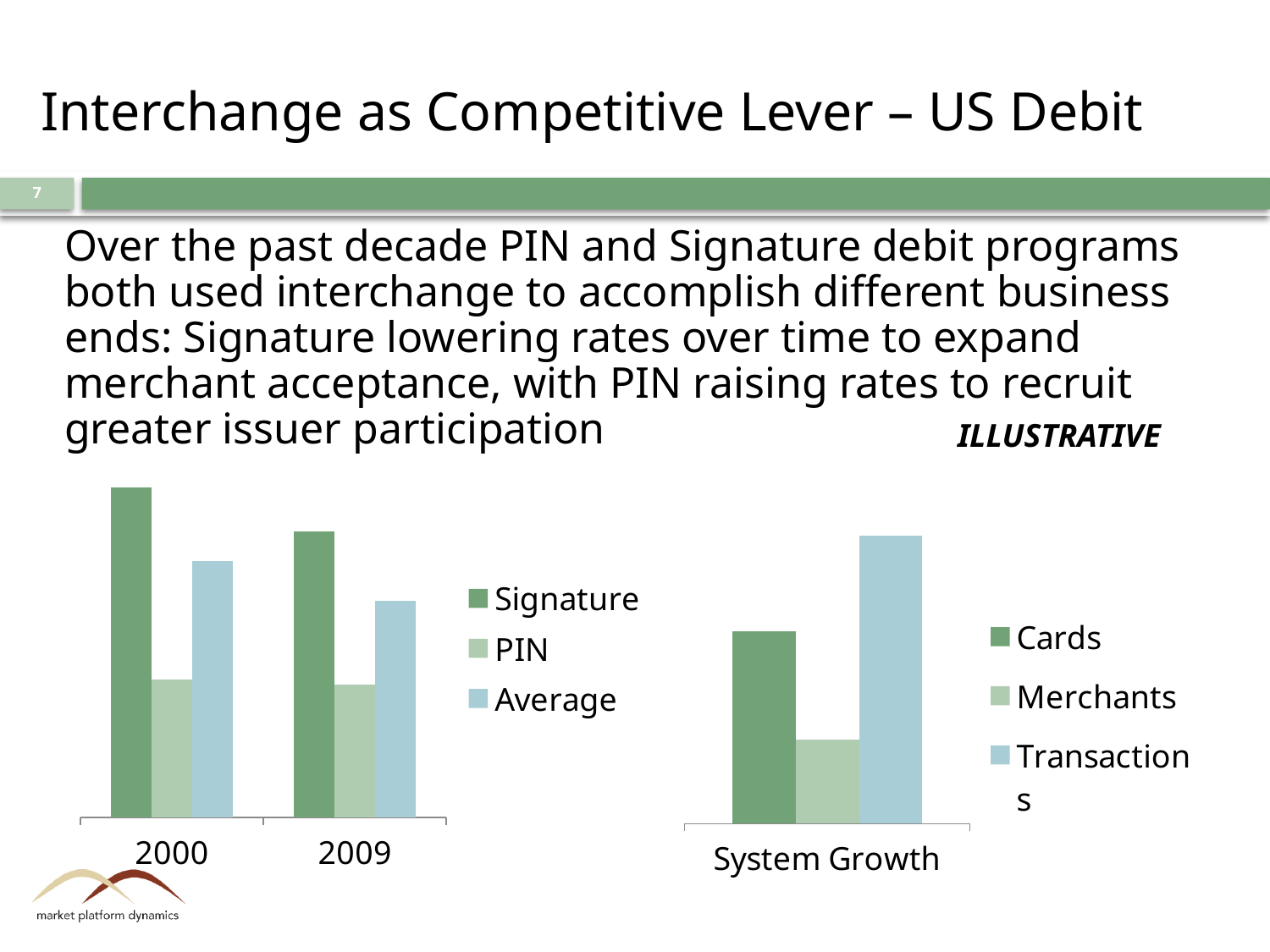
What kind of chart is the left chart with the years 2000 and 2009? bar chart In the right chart (System Growth), which series has the lowest bar? Merchants In the right chart (System Growth), which is larger, Cards or Merchants? Cards In the left chart, how many year categories are shown on the x axis? 2 In the right chart (System Growth), how many series does the legend list? 3 In the right chart (System Growth), which series has the highest bar? Transactions In the left chart, is the Signature bar larger in 2000 or in 2009? 2000 What kind of chart is the right chart labelled System Growth? bar chart In the left chart, how many series does the legend list? 3 In the left chart, which series has the lowest bar in 2009? PIN In the left chart, which series has the highest bar in 2000? Signature In the left chart, does the Average series rise or fall from 2000 to 2009? fall